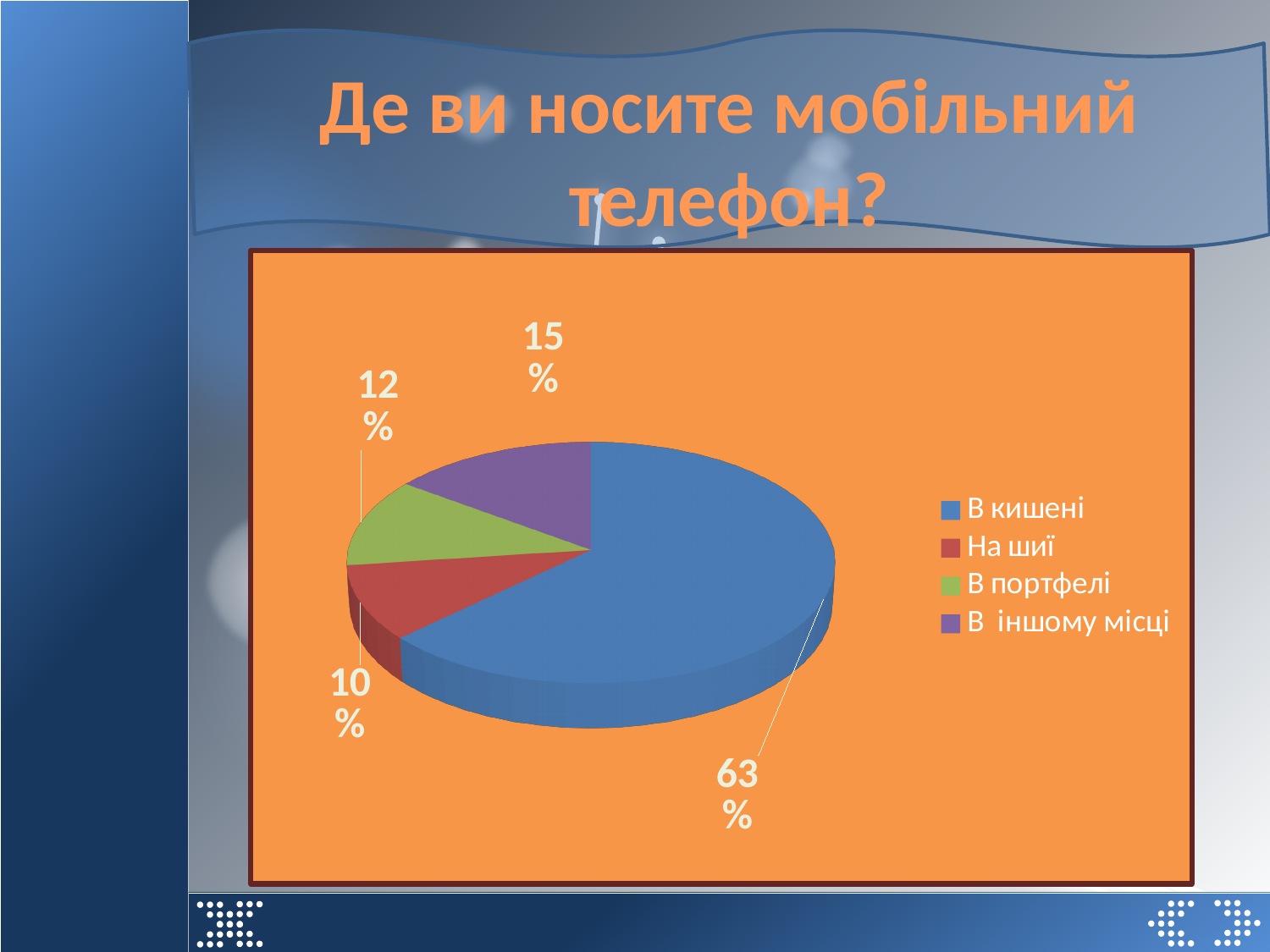
What colour is the slice for "В кишені"? blue What percentage of the pie is labelled for "В іншому місці"? 15% What is the difference in percentage points between "В кишені" and "В іншому місці"? 48 Which category has the largest share of the pie? В кишені What percentage of the pie is labelled for "В портфелі"? 12% What kind of chart is shown on the slide? pie chart Which category has the smallest share of the pie? На шиї What percentage of the pie is labelled for "В кишені"? 63% Which is larger, the share for "В портфелі" or the share for "На шиї"? В портфелі What percentage of the pie is labelled for "На шиї"? 10% What is the title of the chart on the slide? Де ви носите мобільний телефон? How many categories does the legend of the pie chart list? 4